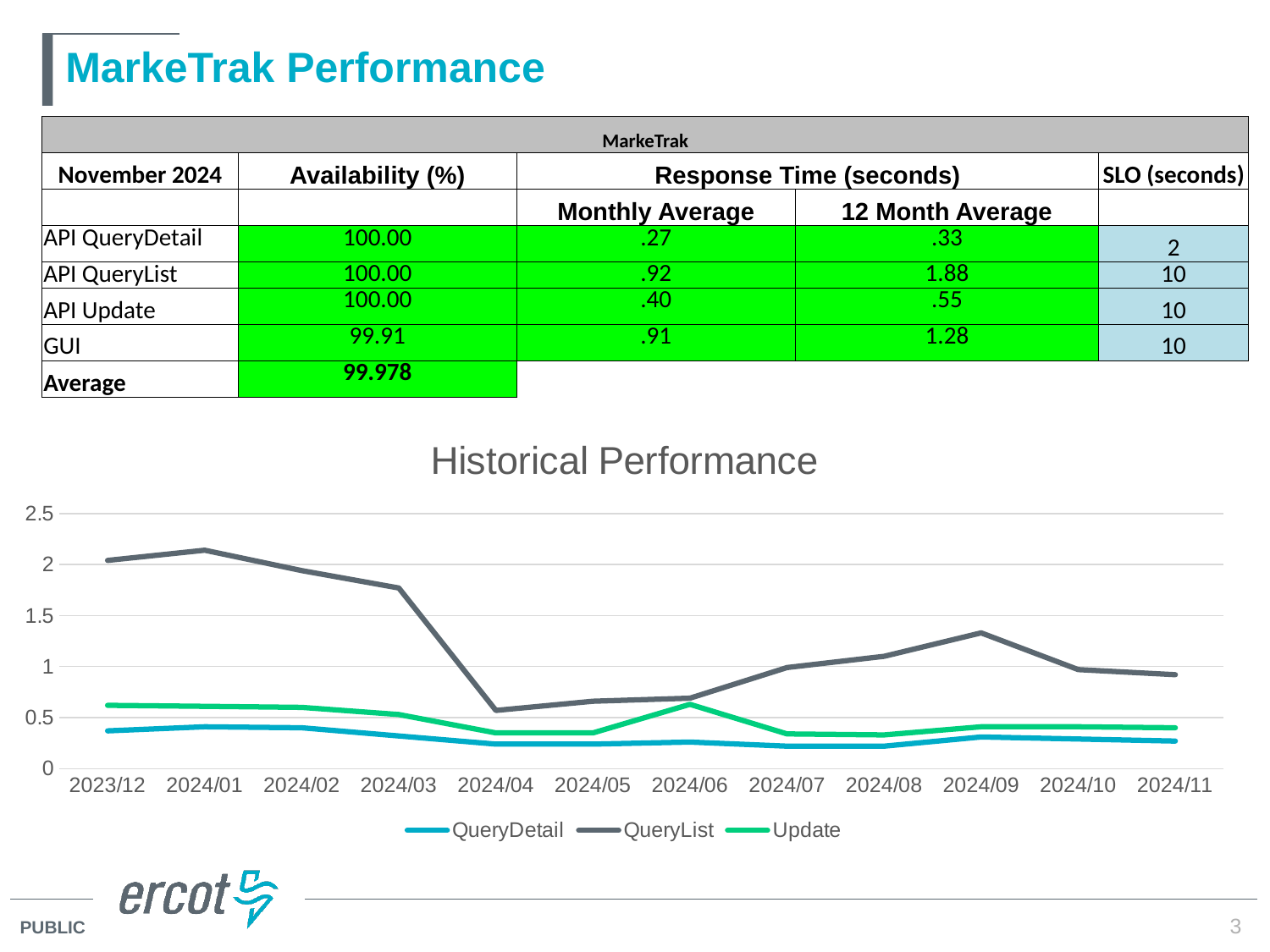
In the Historical Performance chart, in which month does the QueryList series reach its lowest value? 2024/04 In the Historical Performance chart, which series has the higher value at 2024/06, Update or QueryDetail? Update In the Historical Performance chart, is the QueryList value for 2024/04 greater or less than 1? less In the Historical Performance chart, is the QueryDetail value for 2024/08 greater or less than 0.5? less In the Historical Performance chart, which series has the higher value at 2024/09, QueryList or QueryDetail? QueryList In the Historical Performance chart, is the Update value for 2023/12 greater or less than 0.5? greater In the Historical Performance chart, in which month does the QueryList series reach its highest value? 2024/01 How many months are plotted along the x axis of the Historical Performance chart? 12 How many series does the legend of the Historical Performance chart list? 3 In the Historical Performance chart, does the QueryList series rise or fall from 2024/01 to 2024/04? fall What kind of chart is the Historical Performance chart? line chart